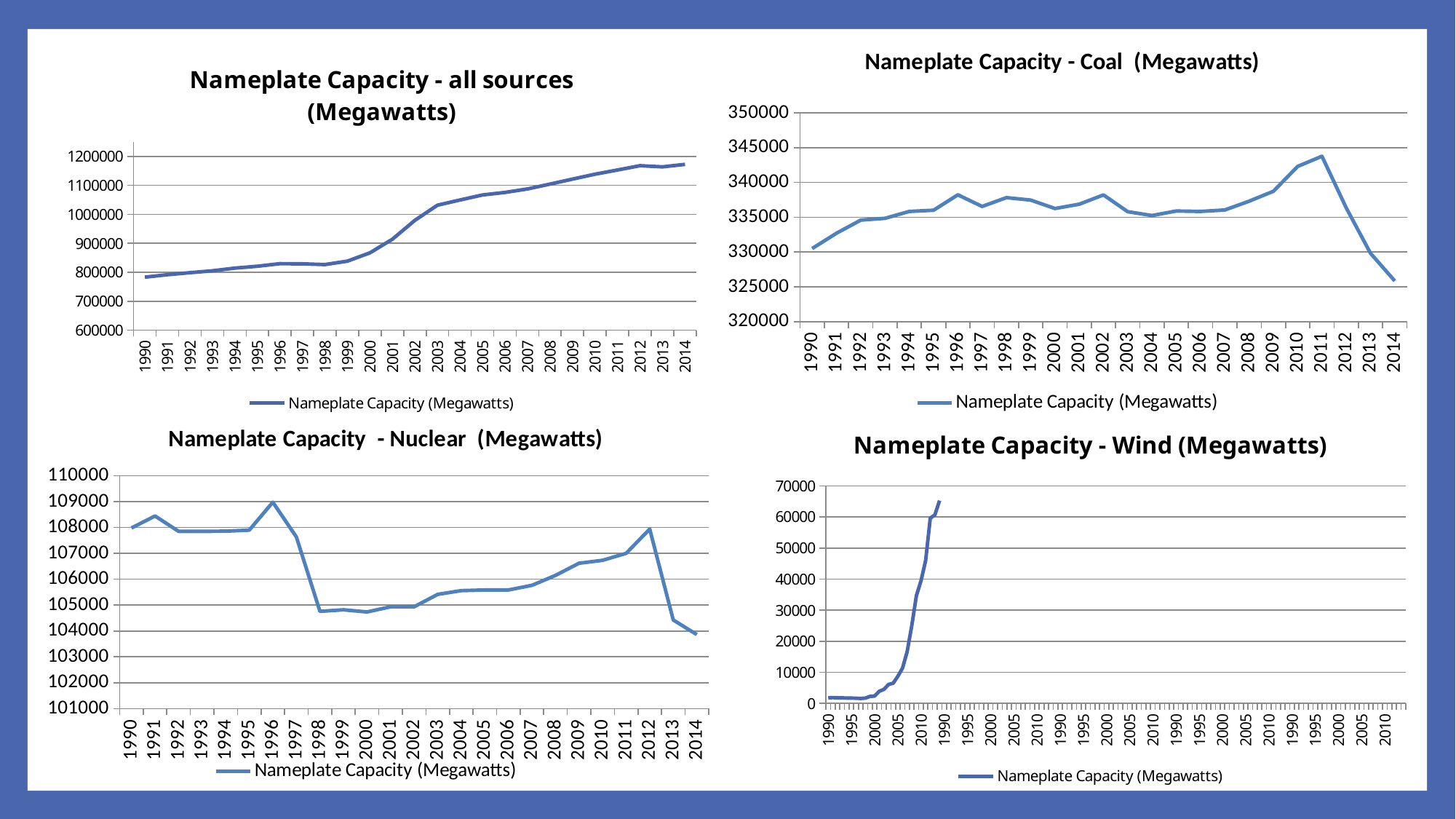
How many years are plotted on the x axis of the 'Nameplate Capacity - all sources (Megawatts)' chart? 25 In the 'Nameplate Capacity - all sources (Megawatts)' chart, is the value for 2014 greater or less than 1100000? greater In the 'Nameplate Capacity - Coal (Megawatts)' chart, which year has the highest value? 2011 In the 'Nameplate Capacity - Wind (Megawatts)' chart, is the value for 1990 greater or less than 10000? less In the 'Nameplate Capacity - Coal (Megawatts)' chart, is the value for 1990 greater or less than 335000? less In the 'Nameplate Capacity - Coal (Megawatts)' chart, which year has the lowest value? 2014 In the 'Nameplate Capacity - Nuclear (Megawatts)' chart, which year has the lowest value? 2014 How many series does the legend of the 'Nameplate Capacity - Coal (Megawatts)' chart list? 1 In the 'Nameplate Capacity - Nuclear (Megawatts)' chart, which year has the highest value? 1996 What kind of chart is the 'Nameplate Capacity - all sources (Megawatts)' chart? line chart In the 'Nameplate Capacity - Nuclear (Megawatts)' chart, which year has the larger value, 1998 or 2009? 2009 In the 'Nameplate Capacity - all sources (Megawatts)' chart, do the values generally rise or fall from 1990 to 2014? rise